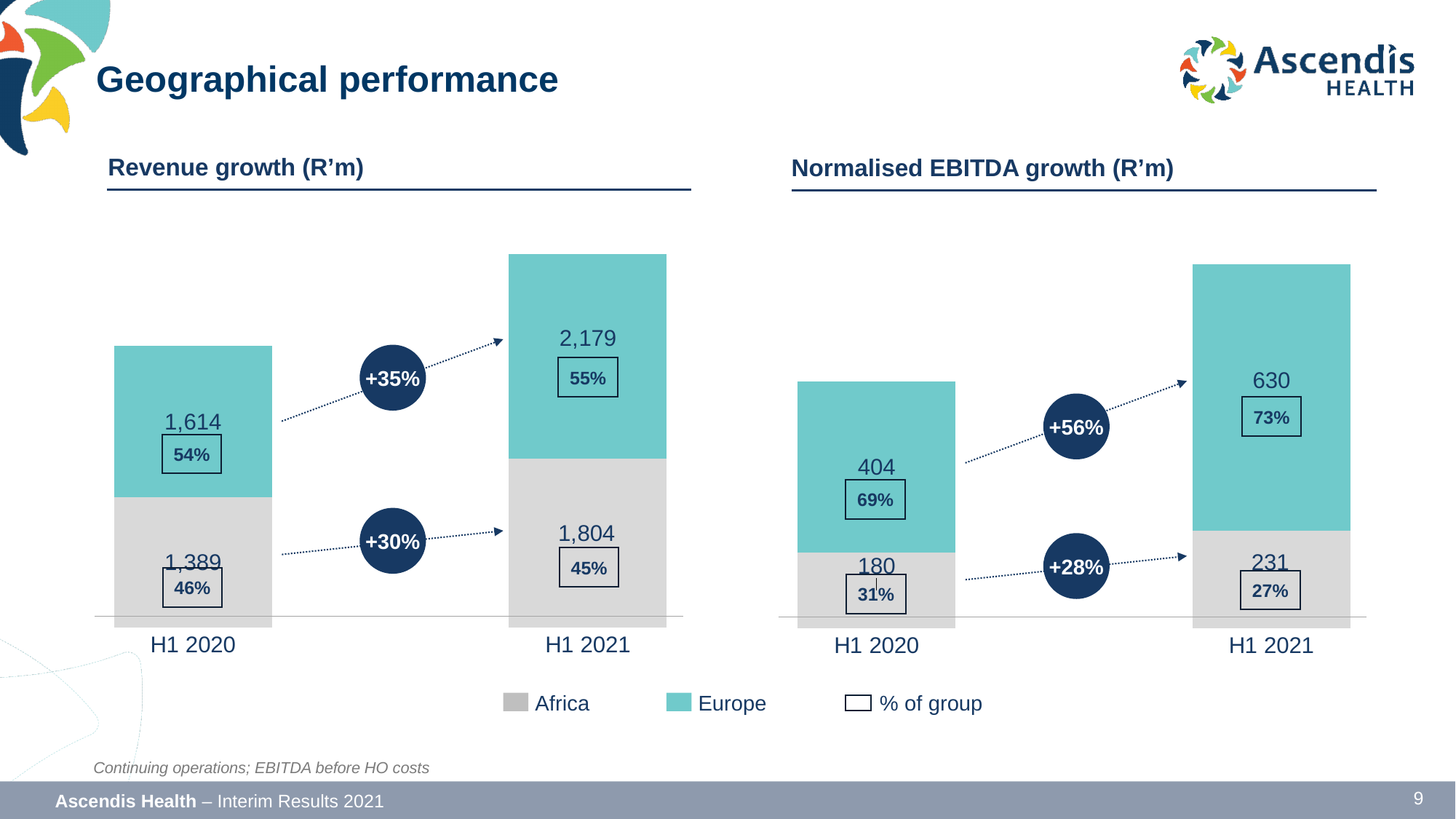
How many series does the legend list for the stacked bars (excluding the % of group marker)? 2 In the Normalised EBITDA growth (R'm) chart, what is the Europe value for H1 2020? 404 In the Revenue growth (R'm) chart, what is the Africa value for H1 2020? 1,389 In the Revenue growth (R'm) chart, does the Africa value rise or fall from H1 2020 to H1 2021? rise In the Revenue growth (R'm) chart, what is the difference between the Europe values for H1 2021 and H1 2020? 565 What type of chart is the Normalised EBITDA growth (R'm) chart? stacked bar chart In the Revenue growth (R'm) chart, what is the Europe value for H1 2021? 2,179 In the Revenue growth (R'm) chart, what is the total of the H1 2021 stacked bar? 3,983 In the Normalised EBITDA growth (R'm) chart, what percentage of the group does Europe represent in H1 2021? 73% In the Normalised EBITDA growth (R'm) chart, which is larger in H1 2021, Africa or Europe? Europe In the Normalised EBITDA growth (R'm) chart, what is the Africa value for H1 2021? 231 In the Normalised EBITDA growth (R'm) chart, what is the total of the H1 2020 stacked bar? 584